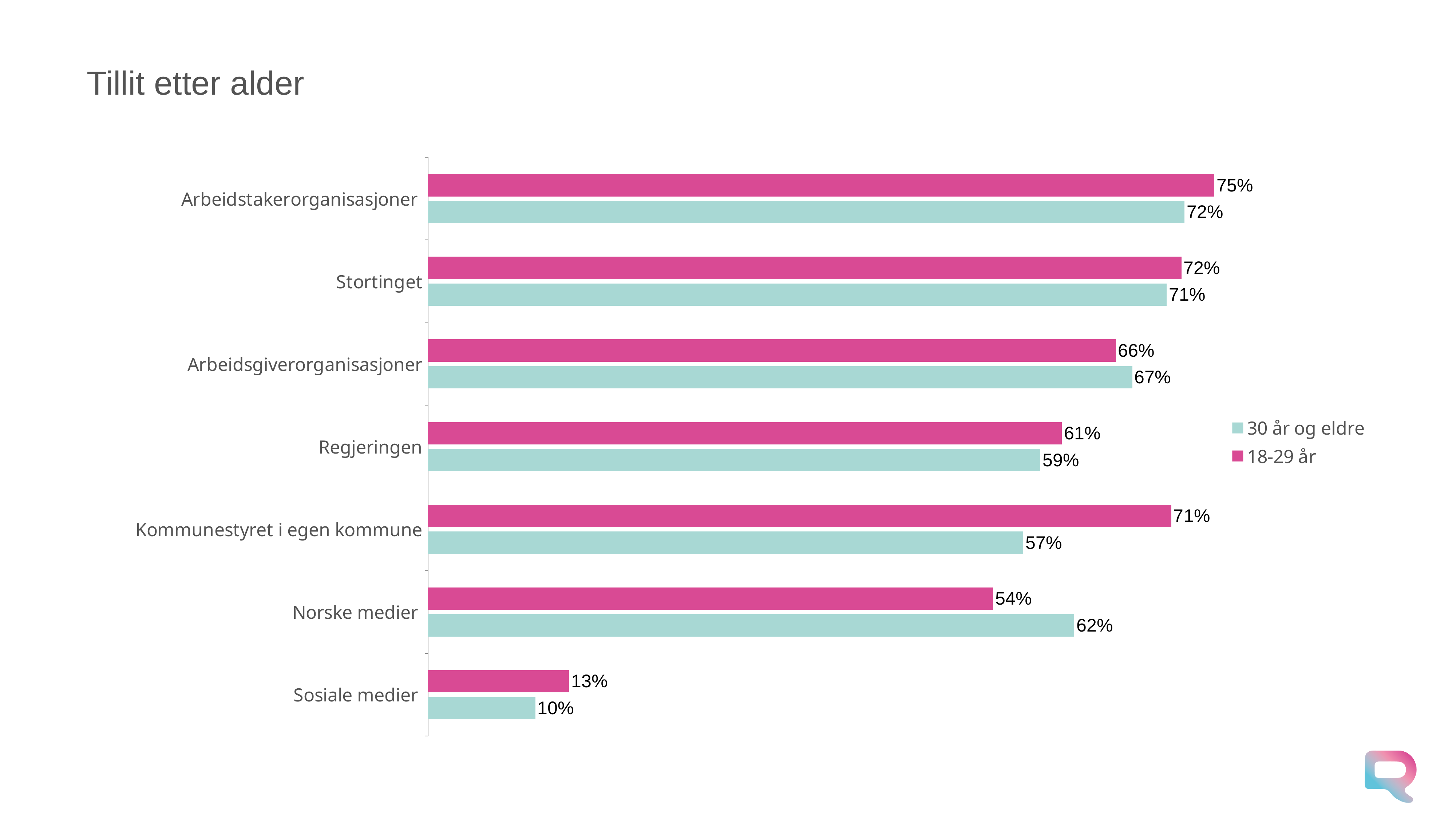
How many categories are shown on the chart? 7 For Regjeringen, which age group has the larger value, 18-29 år or 30 år og eldre? 18-29 år What is the value for 18-29 år for Arbeidstakerorganisasjoner? 75% What is the value for 30 år og eldre for Norske medier? 62% What is the title of the chart? Tillit etter alder What is the value for 30 år og eldre for Kommunestyret i egen kommune? 57% What is the difference between the 30 år og eldre and 18-29 år values for Norske medier? 8% How many series does the legend list? 2 Which category has the highest value for 30 år og eldre? Arbeidstakerorganisasjoner Which category has the lowest value for 18-29 år? Sosiale medier What kind of chart is shown on the slide? Bar chart What is the difference between the 18-29 år and 30 år og eldre values for Kommunestyret i egen kommune? 14%